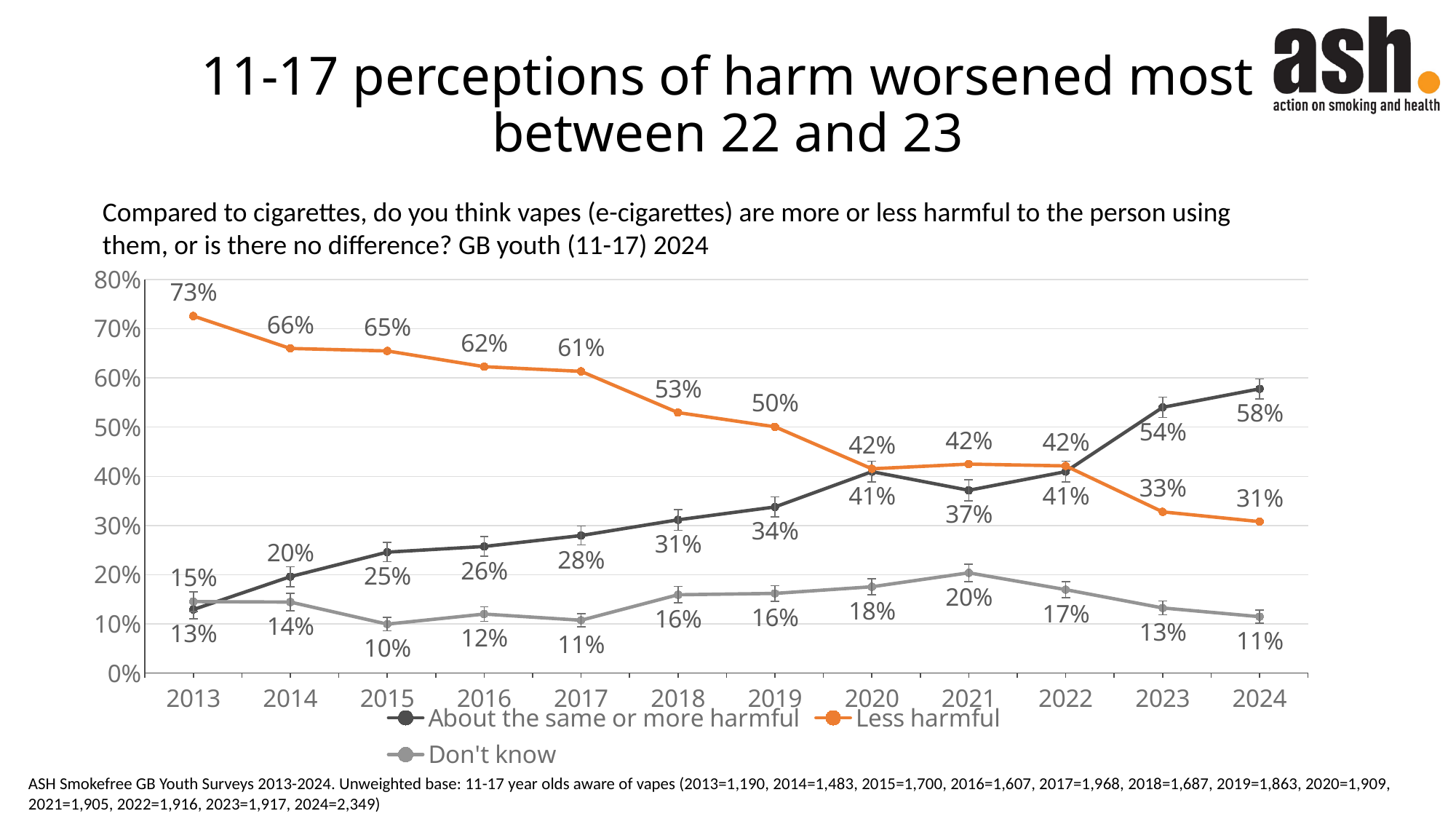
In which year was the 'Less harmful' series at its highest? 2013 What percentage of 11-17 year olds said vapes were less harmful in 2013? 73% By how many percentage points did 'About the same or more harmful' rise from 2013 to 2024? 45 percentage points What kind of chart is shown on the slide? Line chart In 2019, which was larger: 'Less harmful' or 'About the same or more harmful'? Less harmful What is the value for 'Don't know' in 2021? 20% How many years are plotted along the x axis? 12 What is the value for 'About the same or more harmful' in 2024? 58% By how many percentage points did 'Less harmful' fall between 2022 and 2023? 9 percentage points How many series does the legend list? 3 In which year was the 'Don't know' series at its lowest? 2015 Does the 'Less harmful' series generally rise or fall from 2013 to 2024? Fall